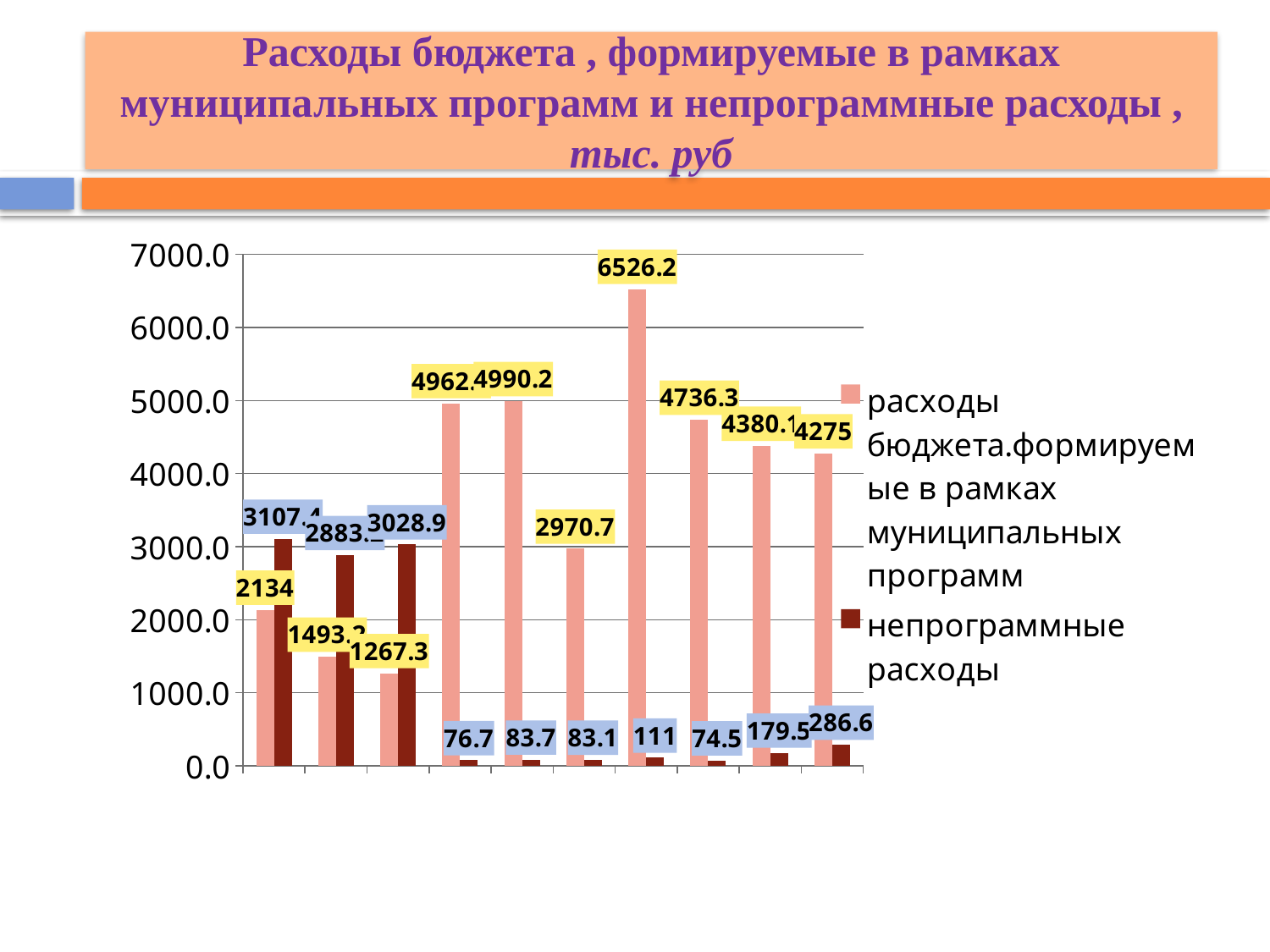
What is the lowest value in the series 'непрограммные расходы'? 74.5 Is the program-expense value for the second group of bars greater or less than 2000.0? less What is the value of 'непрограммные расходы' for the third group of bars from the left? 3028.9 What is the difference between the highest program-expense value (6526.2) and the program-expense value of 2970.7 in the sixth group? 3555.5 What is the highest value in the series 'расходы бюджета, формируемые в рамках муниципальных программ'? 6526.2 How many series does the legend list? 2 How many groups of bars are plotted on the chart? 10 What is the value of 'непрограммные расходы' for the last (tenth) group of bars? 286.6 What is the total of the two bars in the seventh group (6526.2 and 111)? 6637.2 What kind of chart is shown on the slide? bar chart What is the value of 'расходы бюджета, формируемые в рамках муниципальных программ' for the first group of bars from the left? 2134 Which is larger: the program-expense value in the fifth group (4990.2) or in the eighth group (4736.3)? 4990.2 (fifth group)